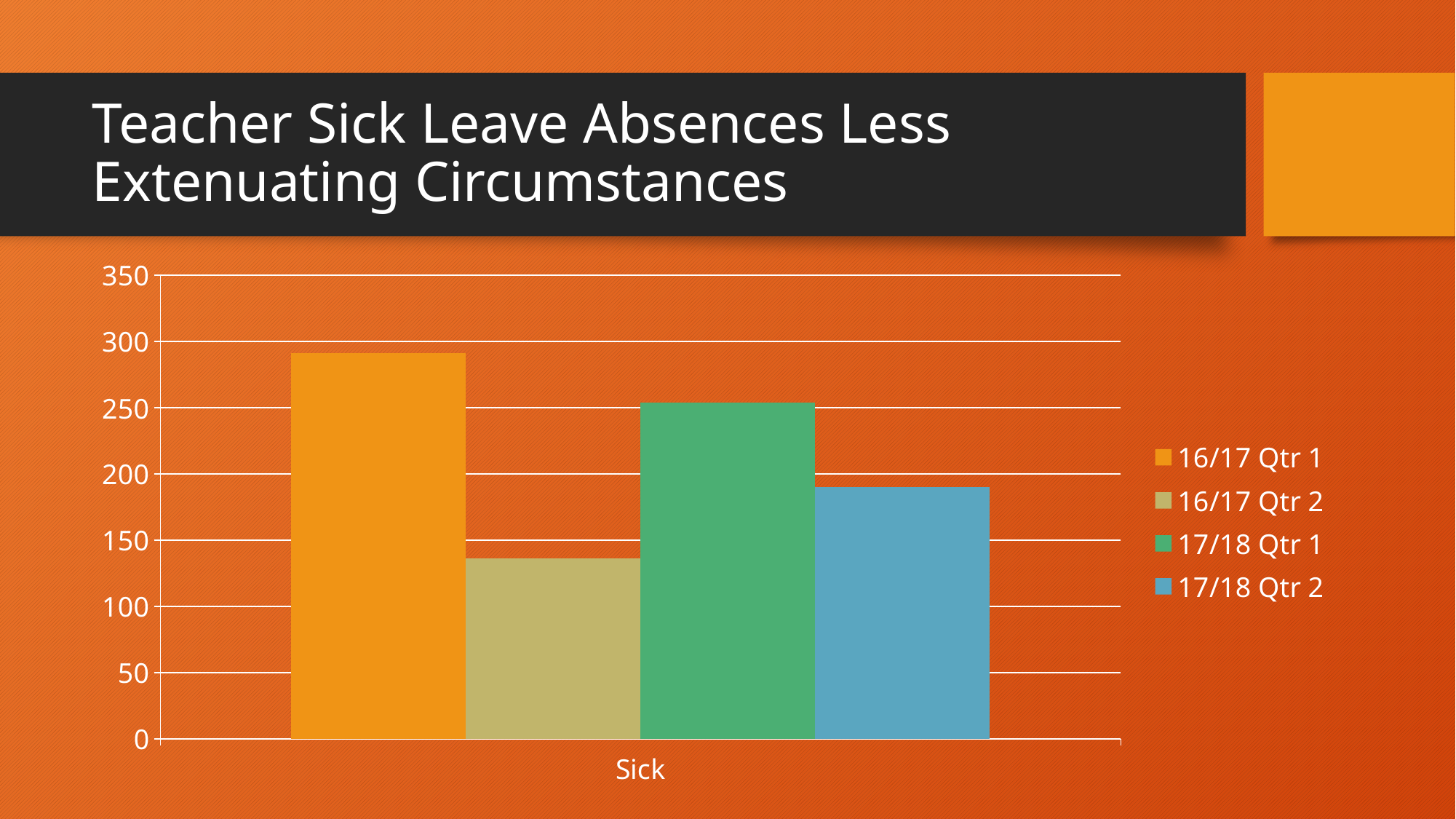
How many series does the legend list? 4 Which is larger for Sick, 17/18 Qtr 1 or 17/18 Qtr 2? 17/18 Qtr 1 Which is larger for Sick, 16/17 Qtr 2 or 17/18 Qtr 2? 17/18 Qtr 2 Is the value for 17/18 Qtr 2 greater or less than 200? less Which series has the highest value for Sick? 16/17 Qtr 1 Which series has the lowest value for Sick? 16/17 Qtr 2 What is the title of the slide containing the chart? Teacher Sick Leave Absences Less Extenuating Circumstances Is the value for 16/17 Qtr 1 greater or less than 300? less Is the value for 16/17 Qtr 2 greater or less than 150? less How many categories are shown on the x axis? 1 What kind of chart is shown on the slide? bar chart